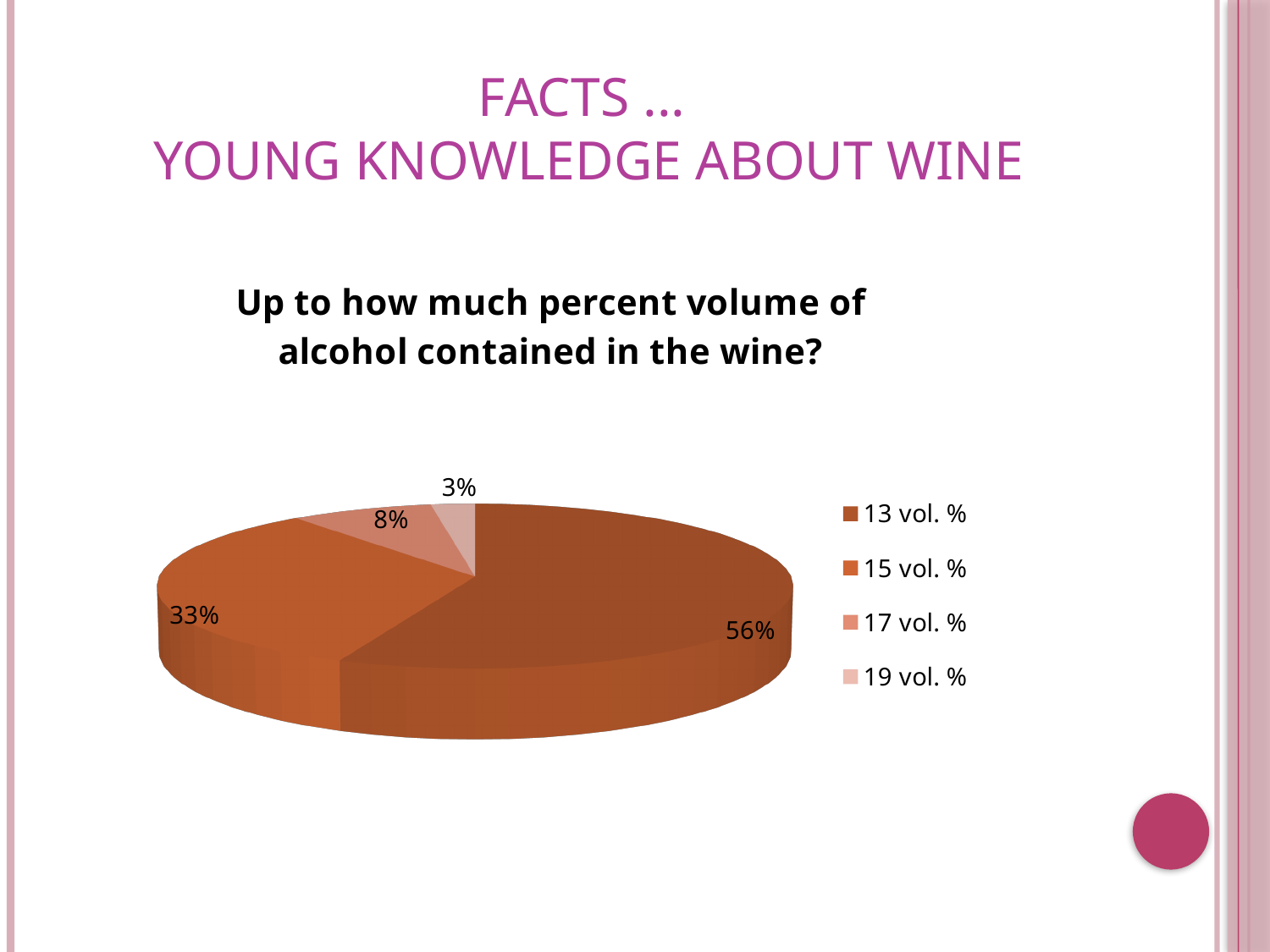
What is the title of the chart? Up to how much percent volume of alcohol contained in the wine? Which category has the largest slice of the pie? 13 vol. % How many categories does the pie chart show? 4 Which slice is larger, 17 vol. % or 19 vol. %? 17 vol. % Which category has the smallest slice of the pie? 19 vol. % What share of the pie does the 19 vol. % slice represent? 3% What share of the pie does the 17 vol. % slice represent? 8% What share of the pie does the 15 vol. % slice represent? 33% What is the difference in percentage points between the 13 vol. % slice and the 15 vol. % slice? 23 What kind of chart is shown on the slide? Pie chart What is the difference in percentage points between the 17 vol. % slice and the 19 vol. % slice? 5